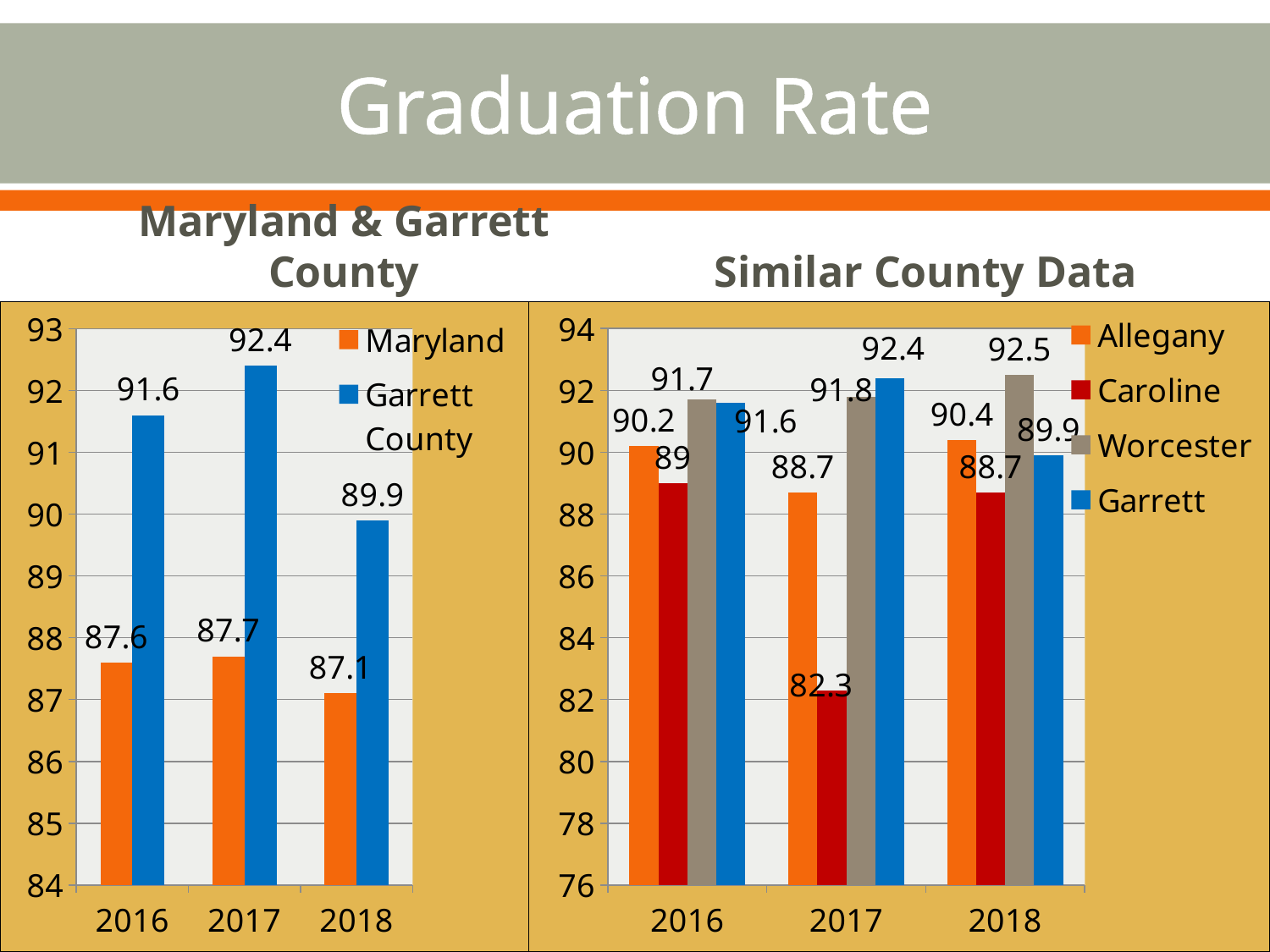
What kind of chart is the Similar County Data chart? Bar chart In the Maryland & Garrett County chart, what is the value for Maryland in 2016? 87.6 In the Maryland & Garrett County chart, how many series does the legend list? 2 In the Similar County Data chart, is the value for Allegany in 2016 larger than the value for Caroline in 2016? Yes In the Maryland & Garrett County chart, what is the value for Garrett County in 2017? 92.4 In the Similar County Data chart, what is the value for Worcester in 2018? 92.5 In the Similar County Data chart, how many series does the legend list? 4 In the Maryland & Garrett County chart, what is the difference between Garrett County and Maryland in 2018? 2.8 In the Similar County Data chart, which county has the lowest value in 2017? Caroline In the Similar County Data chart, what is the value for Caroline in 2017? 82.3 In the Maryland & Garrett County chart, in which year is the Garrett County value lowest? 2018 In the Similar County Data chart, which county has the highest value in 2018? Worcester